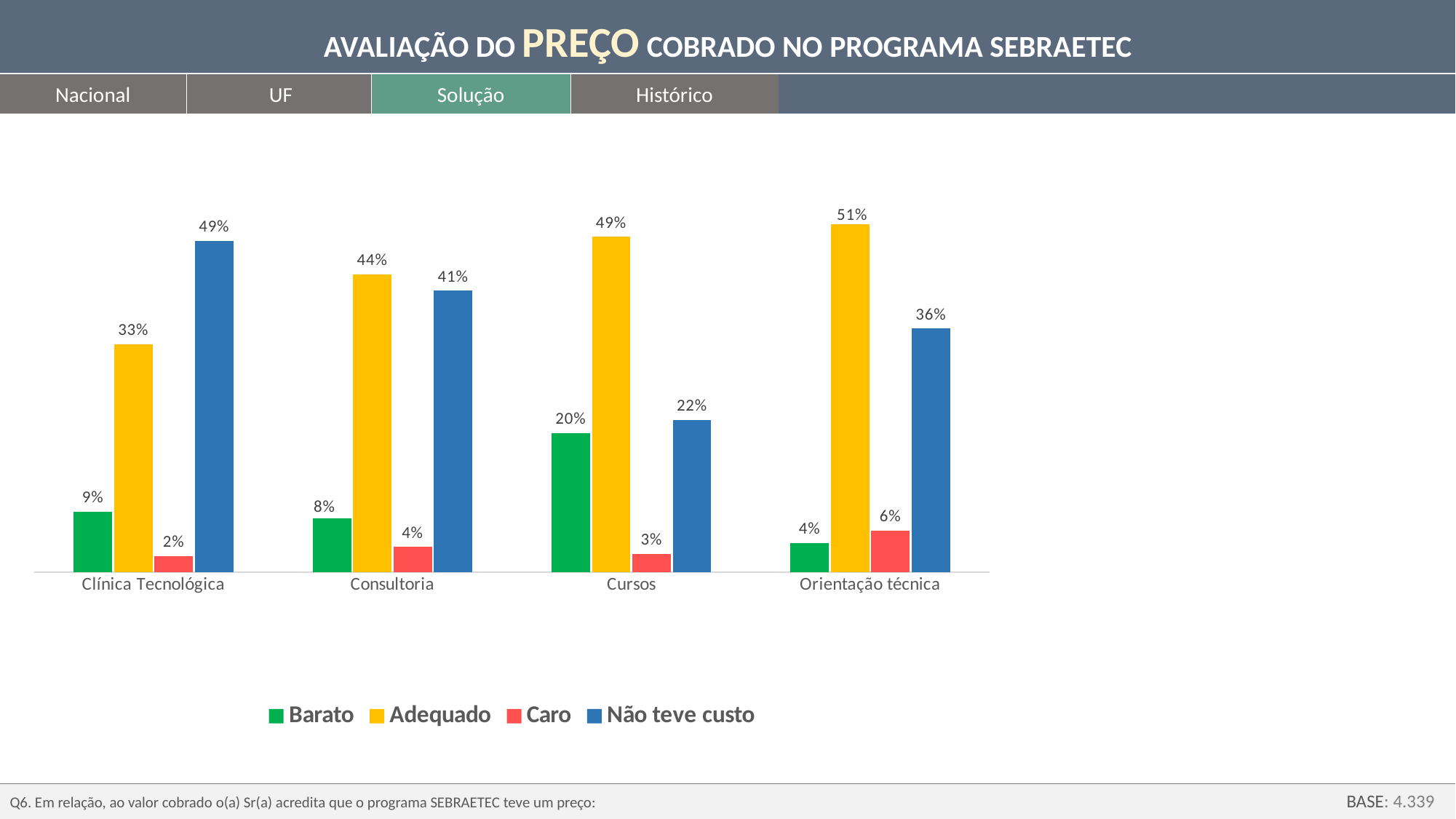
What is the value for Adequado in the Cursos category? 49% How many categories are shown on the x axis? 4 Which category has the lowest value for Caro? Clínica Tecnológica What is the value for Barato in the Consultoria category? 8% What is the value for Não teve custo in the Clínica Tecnológica category? 49% What is the value for Caro in the Orientação técnica category? 6% Which series is shown in blue in the legend? Não teve custo What kind of chart is shown on the slide? Bar chart How many series does the legend list? 4 What is the difference between the Não teve custo values for Clínica Tecnológica and Cursos? 27% Which is larger in the Consultoria category: Adequado or Não teve custo? Adequado Which category has the highest value for Adequado? Orientação técnica